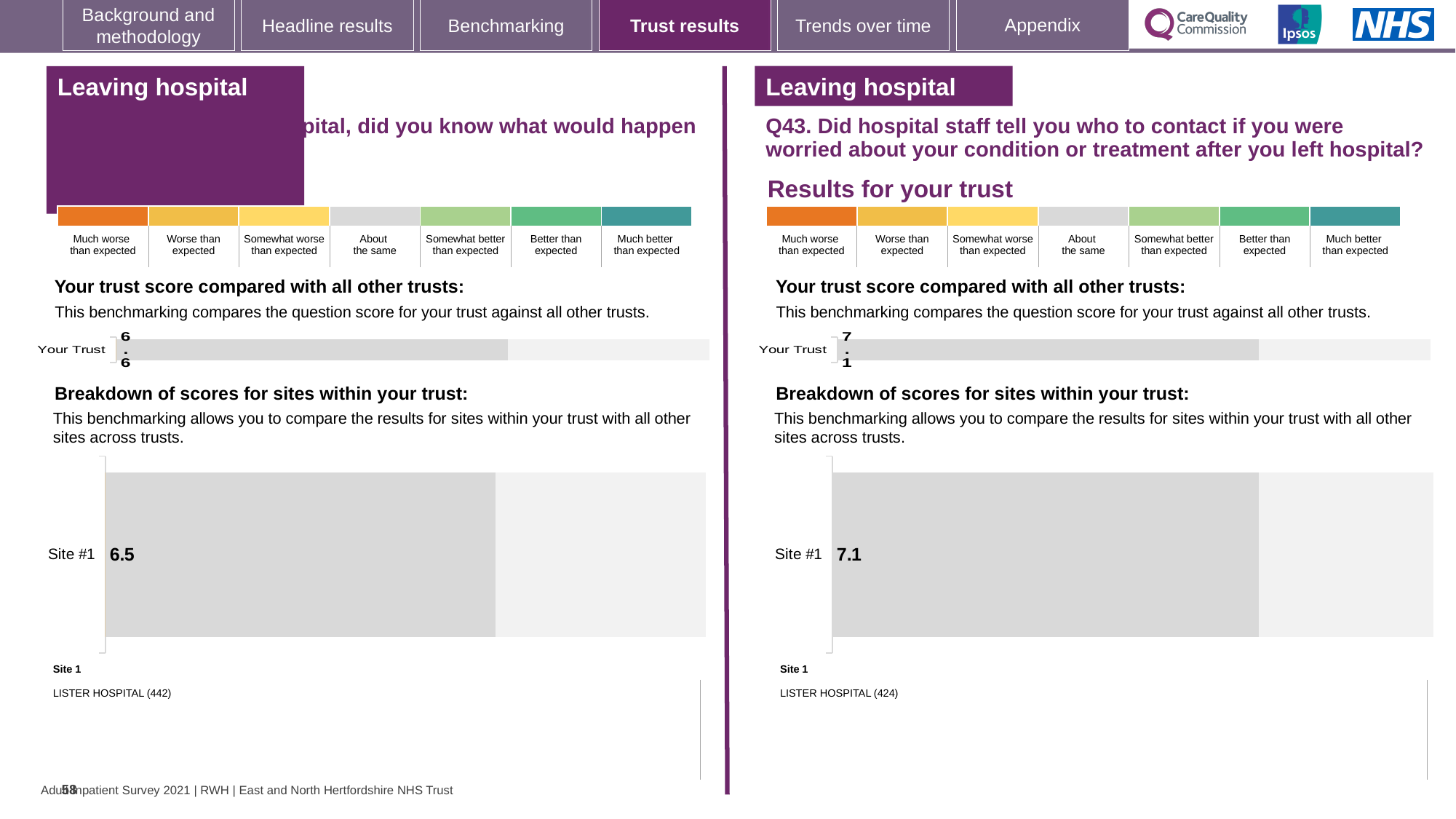
On the right-hand Q43 chart, how many sites are shown in the breakdown of scores for sites within your trust? 1 On the left-hand chart, what is the difference between the Your Trust score and the Site #1 score? 0.1 On the right-hand chart for Q43, what is the score shown for Site #1? 7.1 On the left-hand chart, what number appears in brackets after LISTER HOSPITAL for Site 1? 442 What kind of chart is used to show the breakdown of scores for sites within your trust? Bar chart On the left-hand chart, what is the score shown for Site #1? 6.5 Which is larger: the Site #1 score on the left-hand chart or the Site #1 score on the right-hand Q43 chart? Right-hand Q43 chart (7.1) On the right-hand chart for Q43, what is the score shown for Your Trust? 7.1 What is the difference between the Site #1 score on the right-hand Q43 chart and the Site #1 score on the left-hand chart? 0.6 On the right-hand Q43 chart, which hospital is listed as Site 1? LISTER HOSPITAL (424) On the left-hand chart, which is larger: the Your Trust score or the Site #1 score? Your Trust (6.6) On the left-hand chart, what is the score shown for Your Trust? 6.6